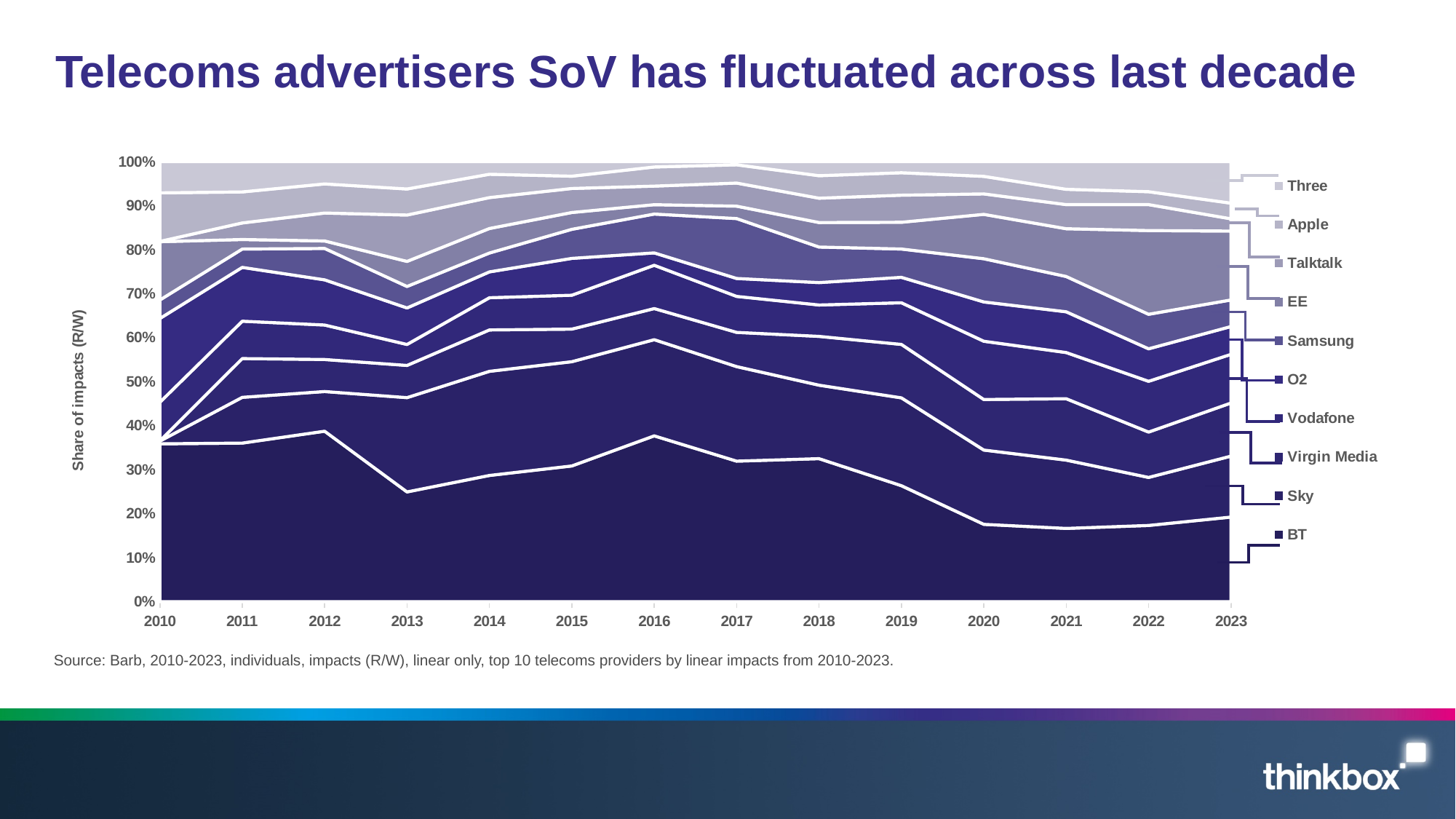
What kind of chart is shown on the slide? Stacked area chart Which series is at the bottom of the stack? BT What is the label on the y axis? Share of impacts (R/W) Is the value for BT in 2016 greater or less than 30%? greater Which is larger, BT's share of impacts in 2012 or in 2020? 2012 Does BT's share of impacts rise or fall between 2016 and 2021? fall Is the value for BT in 2010 greater or less than 30%? greater In which year is BT's share of impacts lowest? 2021 Is the value for BT in 2021 greater or less than 20%? less How many series does the legend list? 10 How many years are shown along the x axis? 14